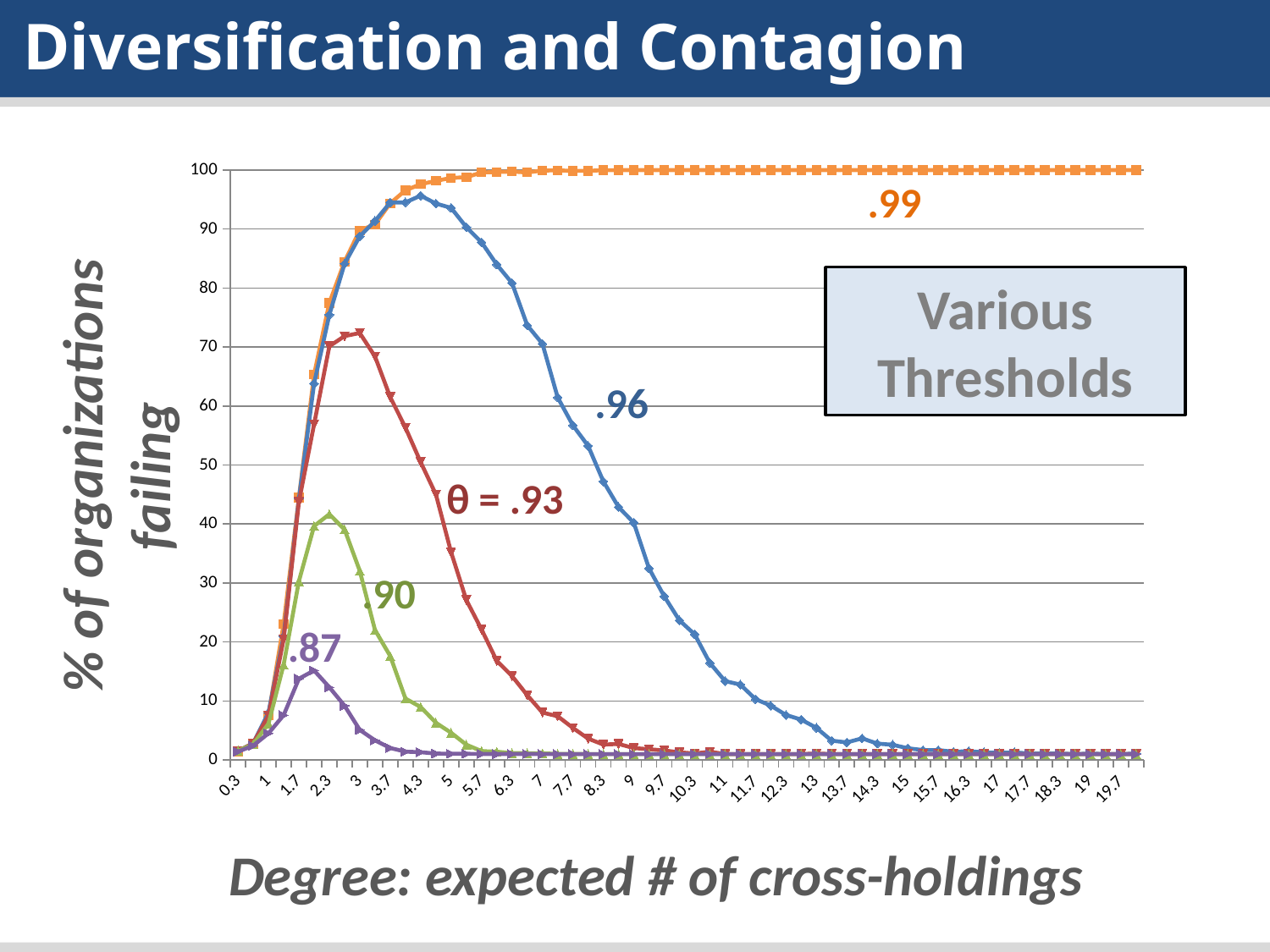
Which series has the higher peak, the .96 series or the θ = .93 series? .96 What kind of chart is shown on the slide? line chart Is the value for the .96 series at degree 10.3 greater or less than 50? less Which threshold series has the lowest peak on the chart? .87 After its peak, does the .96 series rise or fall as degree increases? fall Is the value for the .99 series at degree 10.3 greater or less than 90? greater Is the peak value of the 90 series greater or less than 50? less What is the label of the x axis? Degree: expected # of cross-holdings Which threshold series reaches the highest value on the chart? .99 How many series (threshold curves) are plotted on the chart? 5